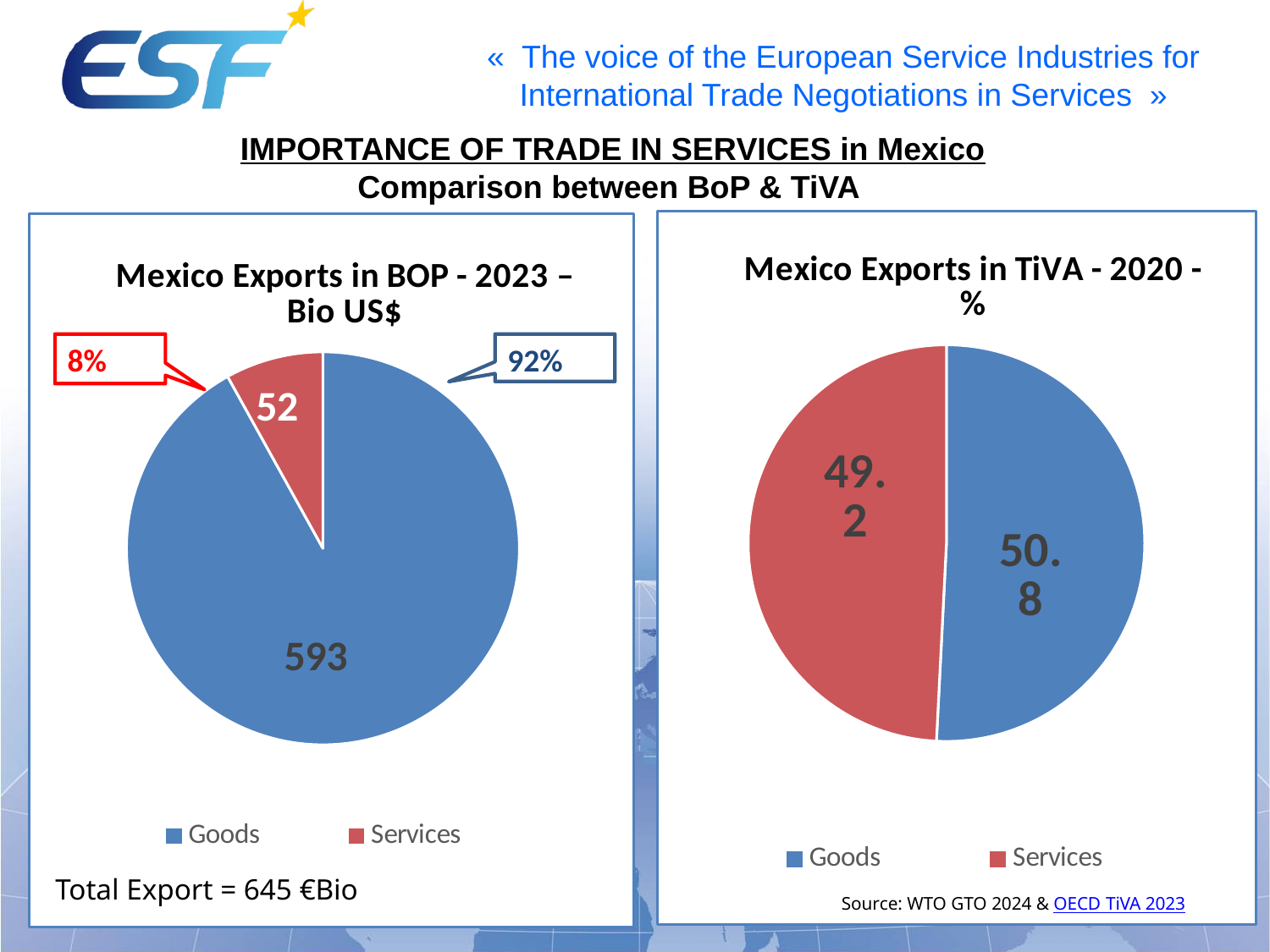
In the 'Mexico Exports in TiVA - 2020' chart, what is the value for Services? 49.2 In the 'Mexico Exports in BOP - 2023' chart, what is the difference between Goods and Services? 541 How many categories does the 'Mexico Exports in BOP - 2023' chart show? 2 In the 'Mexico Exports in BOP - 2023' chart, which category is the largest? Goods In the 'Mexico Exports in BOP - 2023' chart, what percentage share does the Services slice represent? 8% In the 'Mexico Exports in TiVA - 2020' chart, what is the difference between Goods and Services? 1.6 In the 'Mexico Exports in BOP - 2023' chart, what is the value for Goods? 593 In the 'Mexico Exports in TiVA - 2020' chart, what is the value for Goods? 50.8 In the 'Mexico Exports in BOP - 2023' chart, what is the value for Services? 52 What kind of chart is the 'Mexico Exports in TiVA - 2020' chart? Pie chart What colour represents Services in the 'Mexico Exports in TiVA - 2020' chart? Red In the 'Mexico Exports in BOP - 2023' chart, what percentage share does the Goods slice represent? 92%